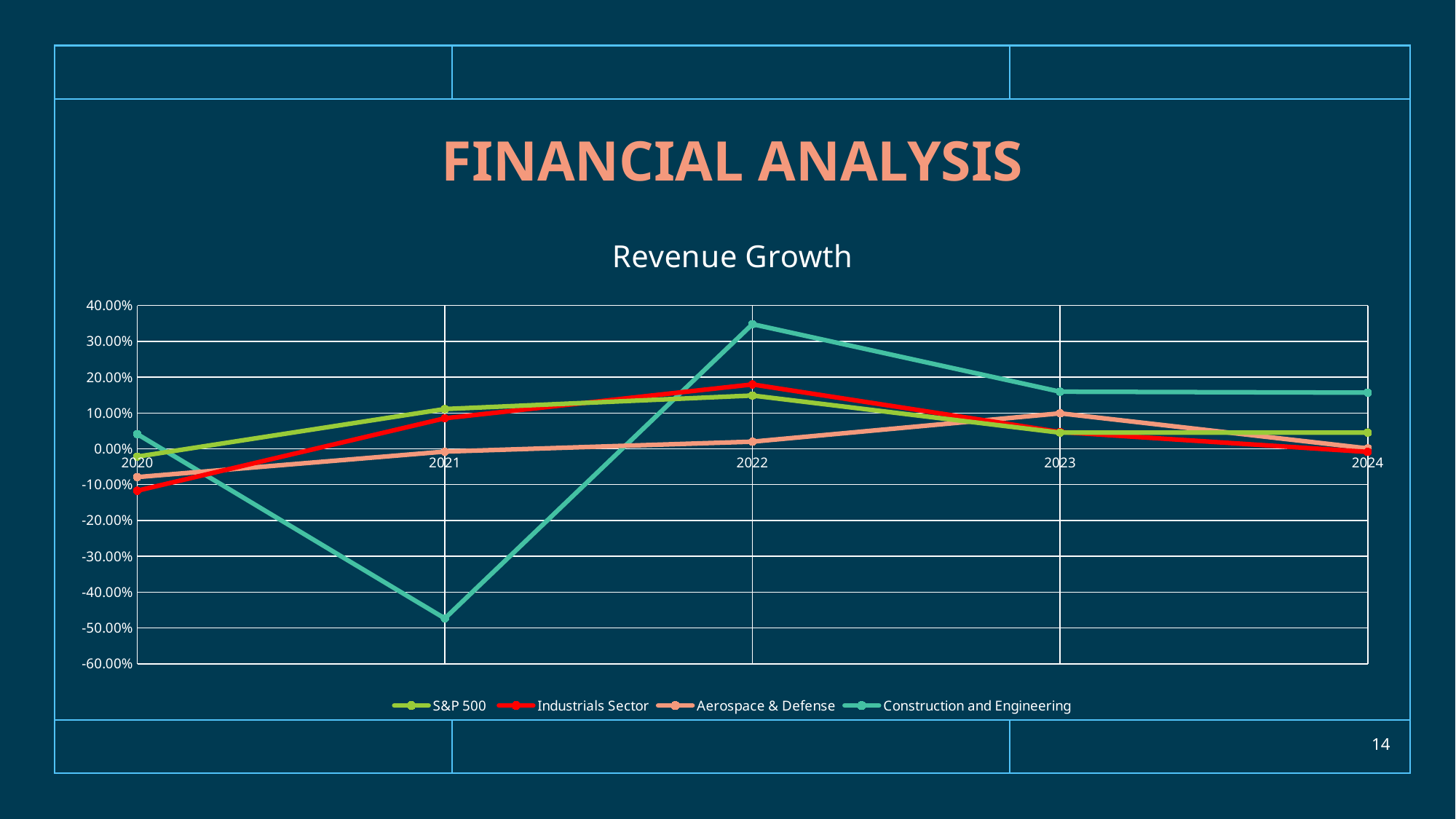
In 2020, which is higher: Industrials Sector or Aerospace & Defense? Aerospace & Defense What kind of chart is shown on the slide? line chart Is the value for Construction and Engineering in 2021 greater or less than -40.00%? less How many series does the legend of the Revenue Growth chart list? 4 Is the value for Industrials Sector in 2022 greater or less than 10.00%? greater What is the title of the chart? Revenue Growth In which year is the Construction and Engineering series at its lowest? 2021 How many years are shown on the x axis of the Revenue Growth chart? 5 Is the value for Construction and Engineering in 2022 greater or less than 30.00%? greater Which series has the highest value in 2022? Construction and Engineering In which year is the Construction and Engineering series at its highest? 2022 Does the Aerospace & Defense series rise or fall from 2020 to 2023? rise